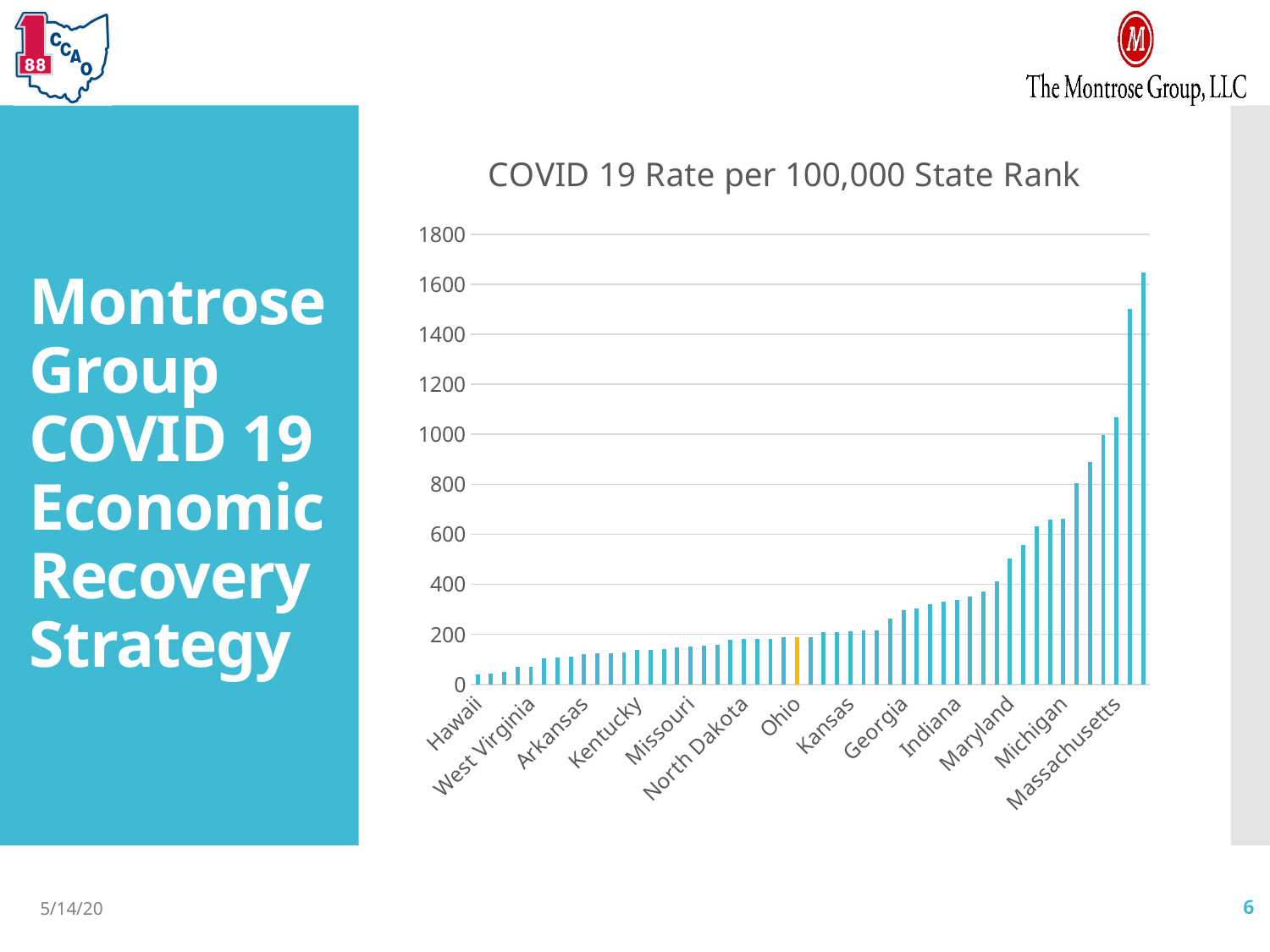
Which labelled state has the lowest COVID 19 rate per 100,000? Hawaii Which has the higher COVID 19 rate per 100,000, Hawaii or Massachusetts? Massachusetts What kind of chart is shown on the slide? bar chart Is the value for Kentucky greater or less than 200? less Is the value for Michigan greater or less than 400? greater Is the value for Massachusetts greater or less than 800? greater Which state's bar is shown in a different colour (orange) from the rest? Ohio What is the title of the chart? COVID 19 Rate per 100,000 State Rank Do the values rise or fall moving from left to right along the x axis? rise Which has the higher COVID 19 rate per 100,000, Michigan or Ohio? Michigan